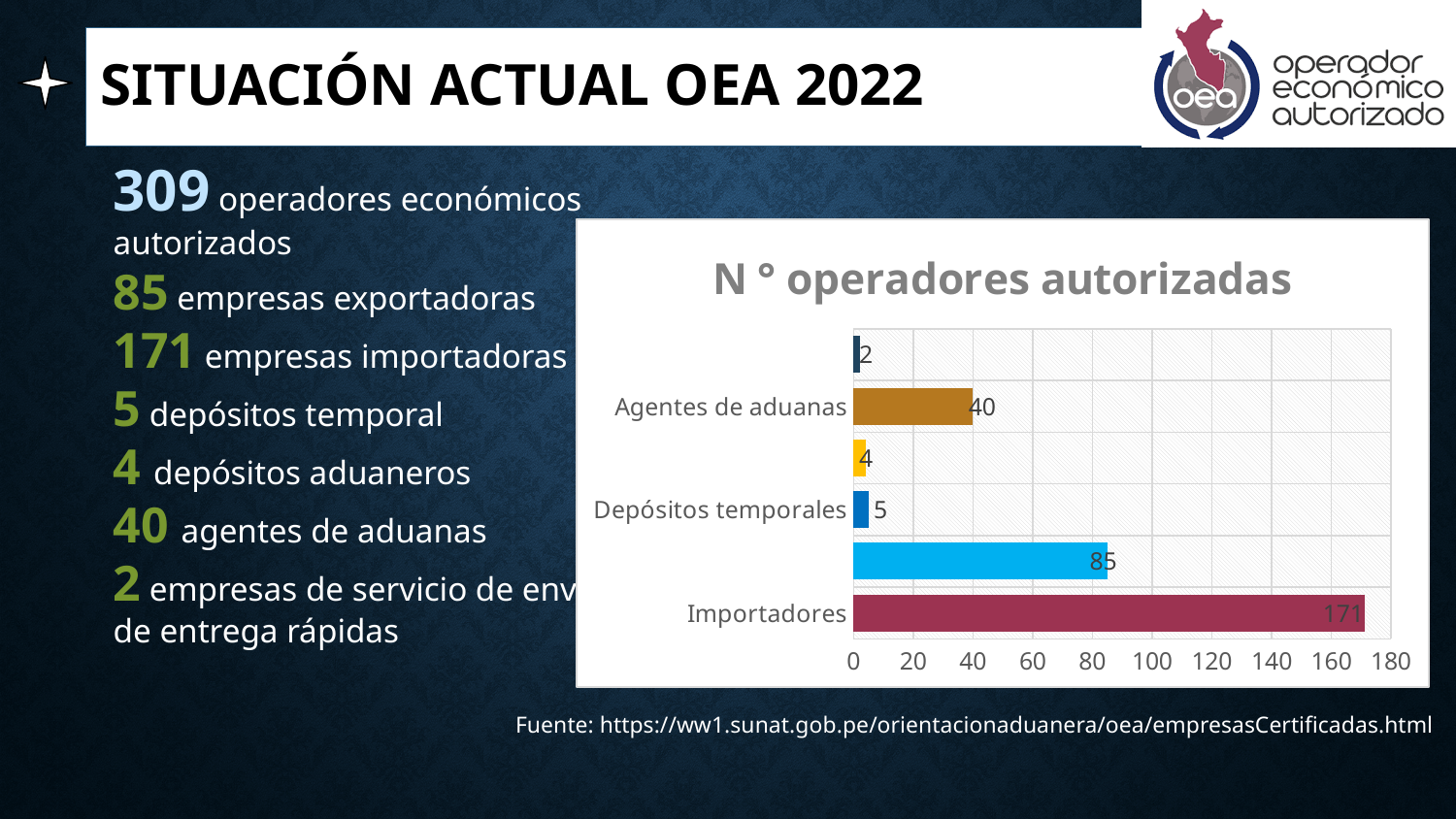
How many bars are plotted in the chart? 6 What is the title of the chart? N ° operadores autorizadas What is the smallest value shown on any bar in the chart? 2 What is the value for Depósitos temporales in the chart? 5 What is the value for Agentes de aduanas in the chart? 40 What is the difference between the values for Importadores and Agentes de aduanas? 131 What is the difference between the values for Agentes de aduanas and Depósitos temporales? 35 What is the value for Importadores in the chart? 171 Is the value for Importadores greater or less than 160? greater Which is larger, the value for Agentes de aduanas or the value for Depósitos temporales? Agentes de aduanas What kind of chart is shown on the slide? bar chart Which category has the highest value in the chart? Importadores